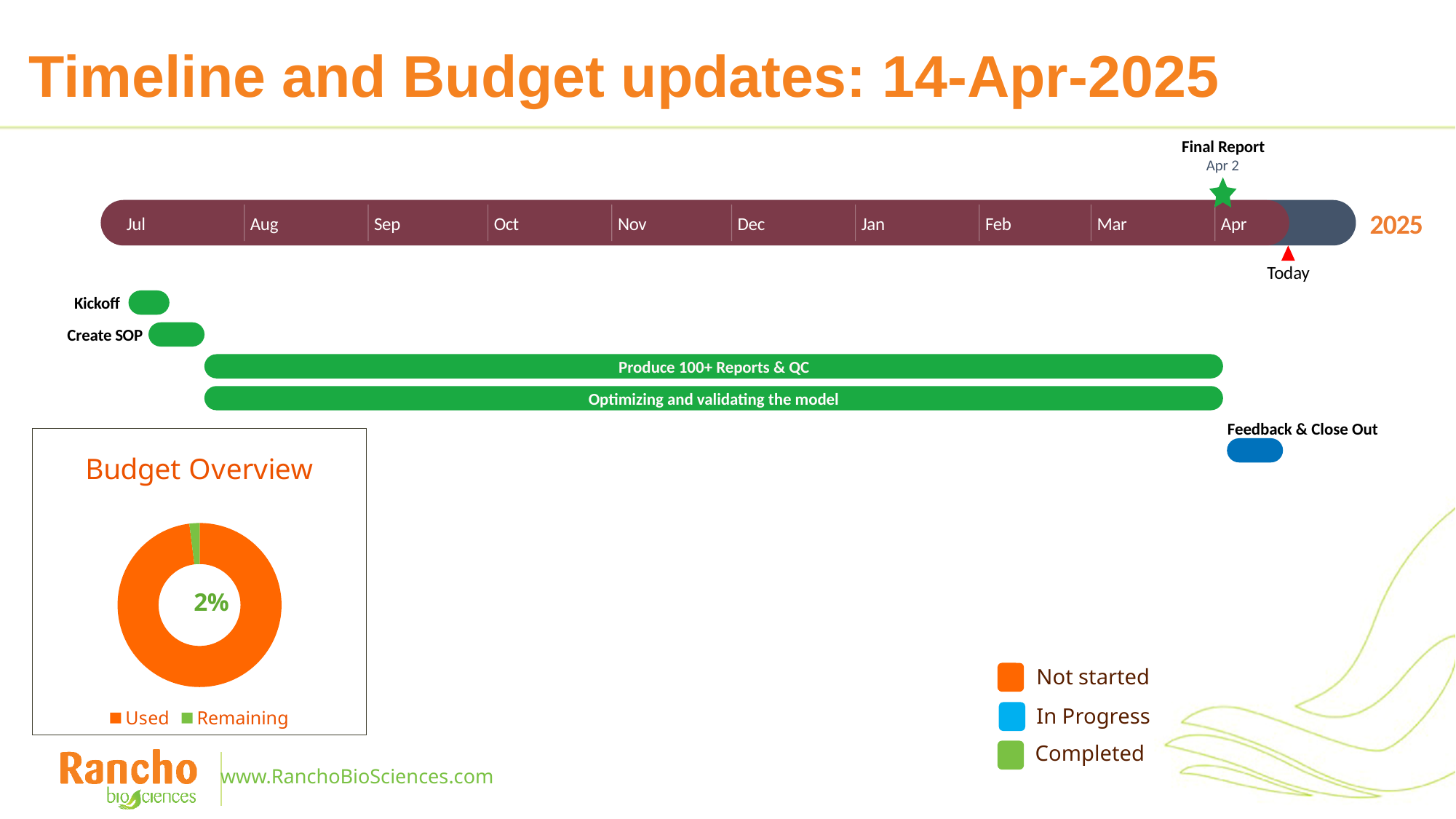
What kind of chart is shown in the Budget Overview panel? Pie chart (donut) In the Budget Overview chart, is the Used slice larger or smaller than the Remaining slice? Larger What percentage value is printed in the centre of the Budget Overview donut chart? 2% What is the title of the chart in the bottom-left panel of the slide? Budget Overview In the Budget Overview chart, which category takes up the larger share of the donut? Used In the Budget Overview chart, what are the two legend entries? Used and Remaining In the Budget Overview chart, which category takes up the smaller share of the donut? Remaining In the Budget Overview chart, what colour represents the Used category? Orange In the Budget Overview chart, how many categories does the legend list? 2